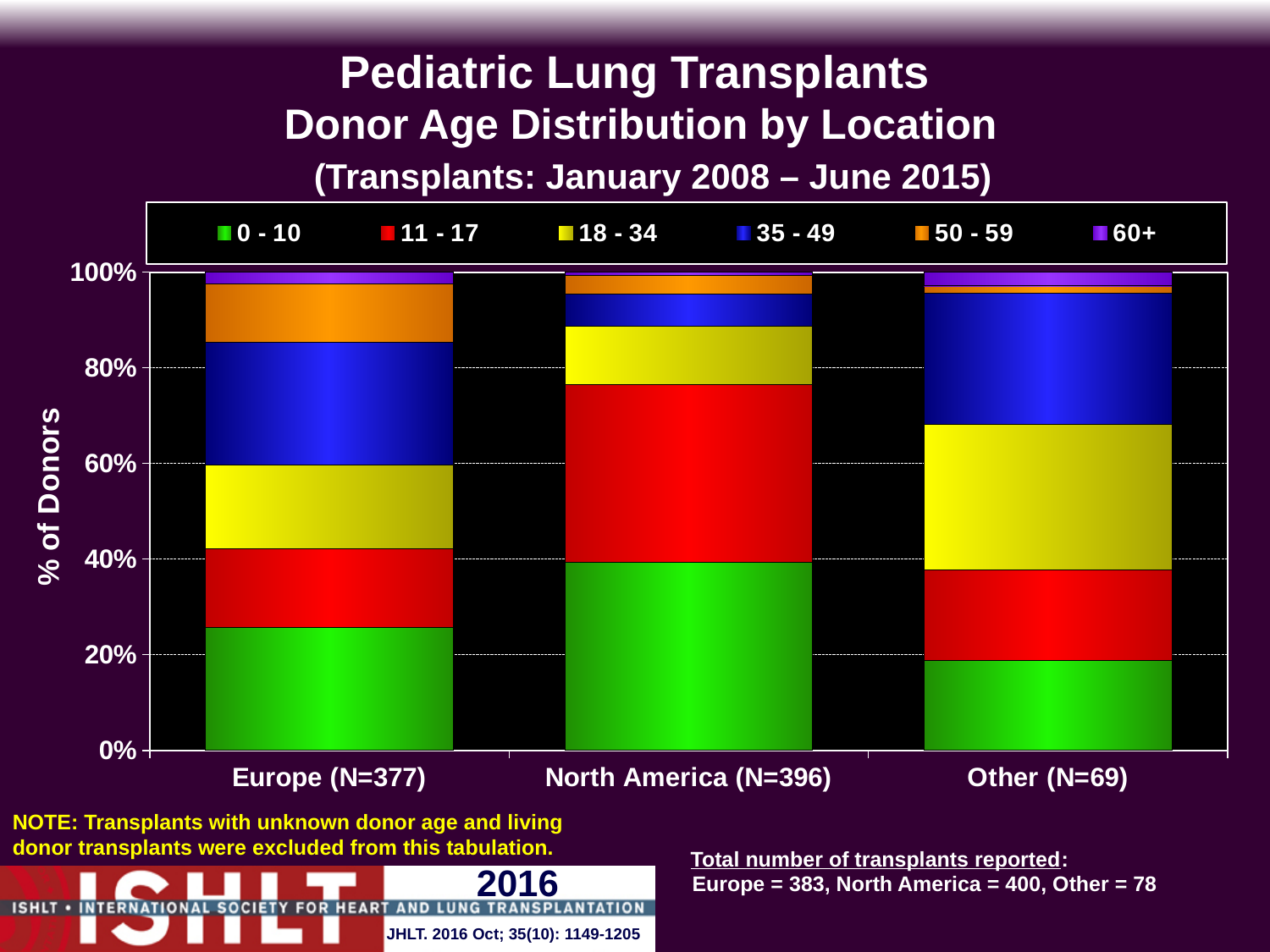
How many donor age groups does the legend list? 6 Is the share of donors aged 0 - 10 for North America greater or less than 20%? greater Which location has the largest share of donors aged 18 - 34? Other (N=69) Is the share of donors aged 0 - 10 for Other greater or less than 40%? less Which location has the largest share of donors aged 11 - 17? North America (N=396) Which location has the largest share of donors aged 50 - 59? Europe (N=377) How many location categories are shown on the x axis? 3 Which location has the smallest share of donors aged 35 - 49? North America (N=396) What kind of chart is shown on the slide? stacked bar chart What is the label on the y axis? % of Donors Is the share of donors aged 0 - 10 for Europe greater or less than 40%? less